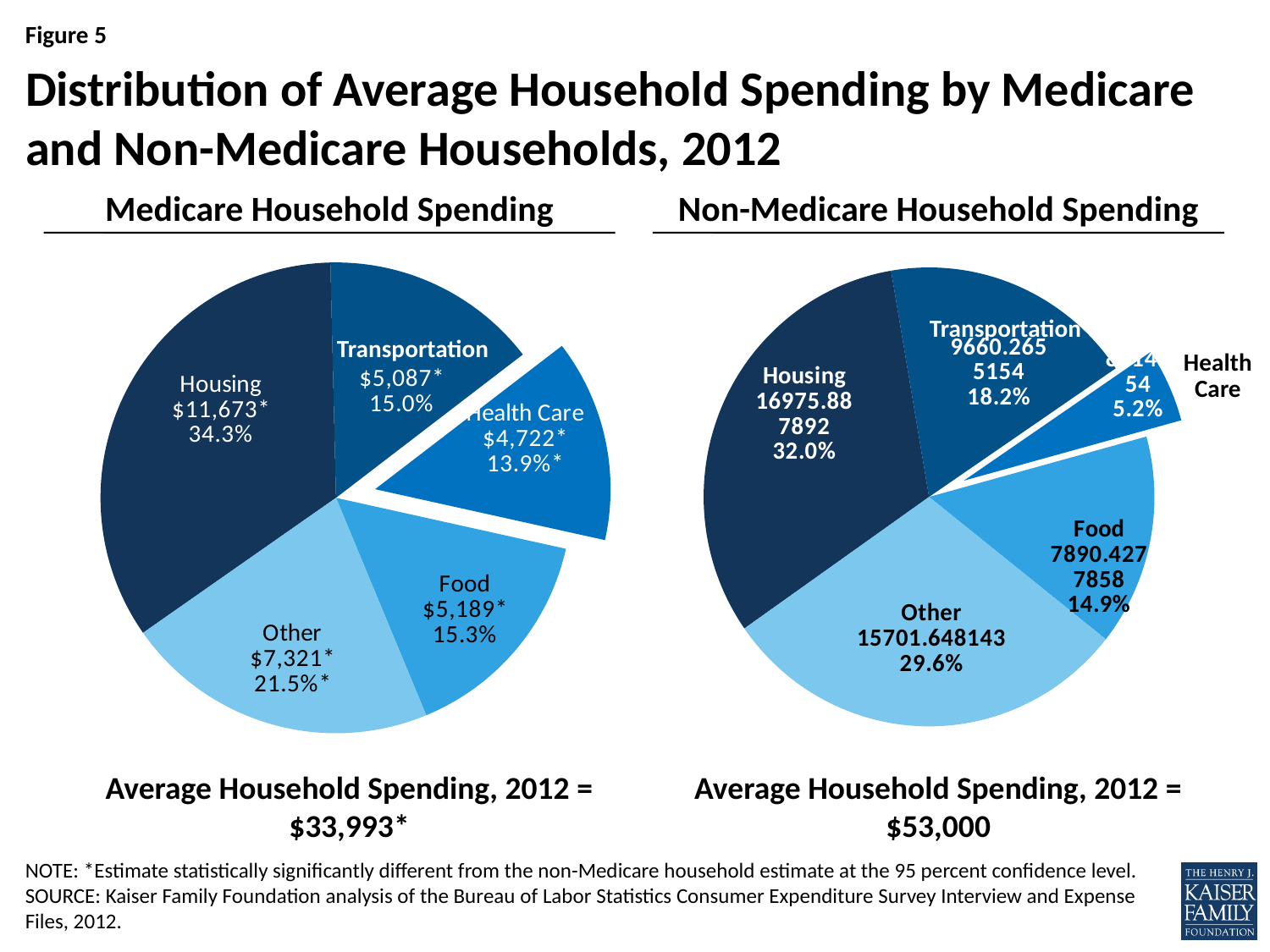
In the Medicare Household Spending chart, which category has the largest share? Housing In the Medicare Household Spending chart, what is the value for Housing? $11,673* What is the average household spending total shown under the Non-Medicare Household Spending chart? $53,000 In the Medicare Household Spending chart, which category has the smallest share? Health Care In the Medicare Household Spending chart, what is the value for Food? $5,189* In the Non-Medicare Household Spending chart, what share of spending goes to Health Care? 5.2% How many categories does each pie chart show? 5 In the Medicare Household Spending chart, what share of spending goes to Health Care? 13.9%* What kind of charts are shown on the slide? Pie charts In the Non-Medicare Household Spending chart, which category has the largest share? Housing In the Non-Medicare Household Spending chart, what share of spending goes to Other? 29.6% In the Medicare Household Spending chart, what is the difference between the Other and Transportation values? $2,234